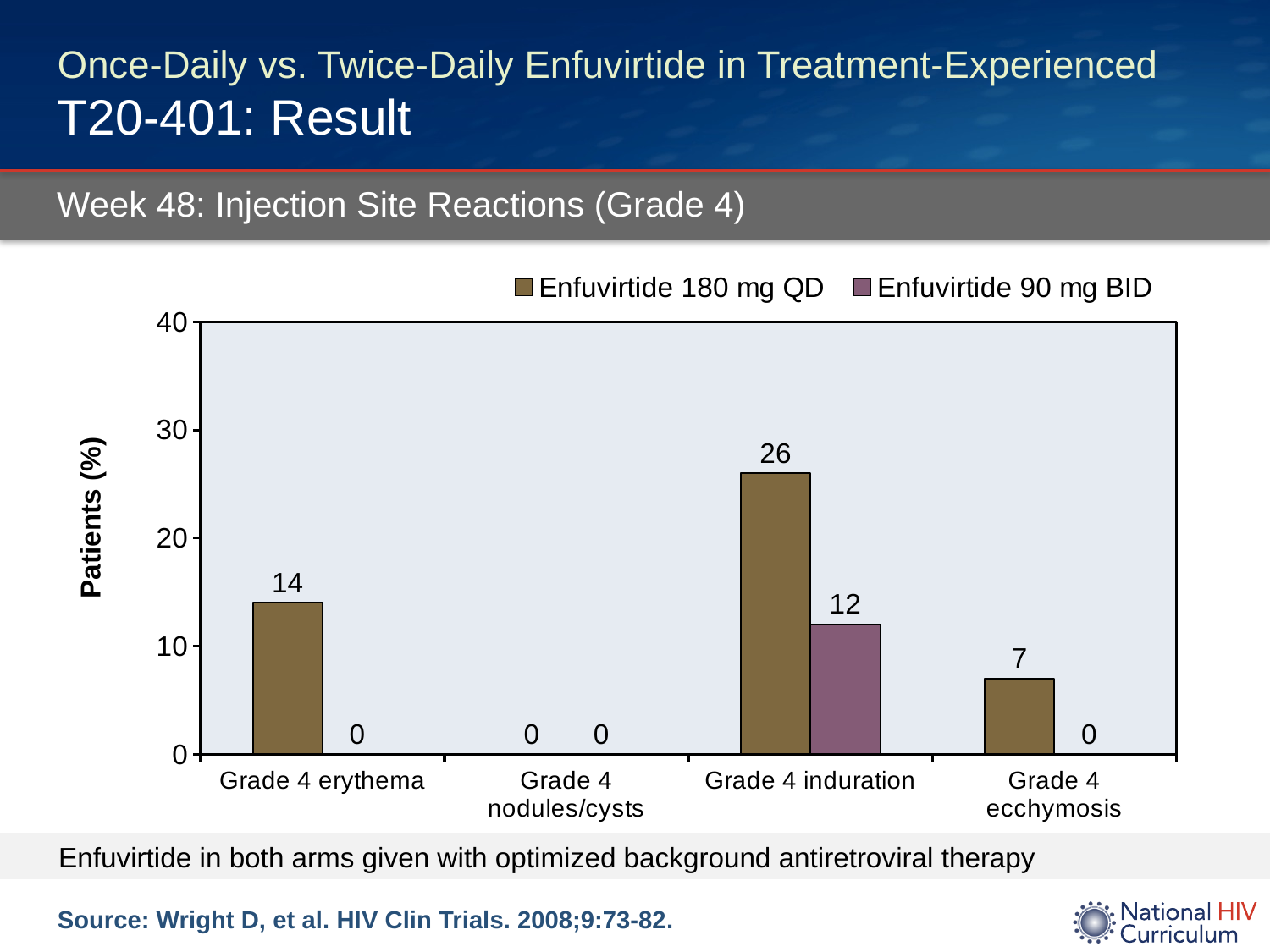
What percentage of patients in the Enfuvirtide 90 mg BID arm had Grade 4 induration? 12 What is the value for Grade 4 erythema in the Enfuvirtide 180 mg QD arm? 14 What is the label of the y axis? Patients (%) For Grade 4 erythema, which arm has the larger value, Enfuvirtide 180 mg QD or Enfuvirtide 90 mg BID? Enfuvirtide 180 mg QD What kind of chart is shown on the slide? Bar chart What is the value for Grade 4 ecchymosis in the Enfuvirtide 90 mg BID arm? 0 What is the difference between the Enfuvirtide 180 mg QD and Enfuvirtide 90 mg BID values for Grade 4 induration? 14 How many injection site reaction categories are shown on the x axis? 4 What percentage of patients in the Enfuvirtide 180 mg QD arm had Grade 4 induration? 26 How many series does the legend list? 2 Which category has the lowest value for the Enfuvirtide 180 mg QD arm? Grade 4 nodules/cysts Which injection site reaction category has the highest value for the Enfuvirtide 180 mg QD arm? Grade 4 induration